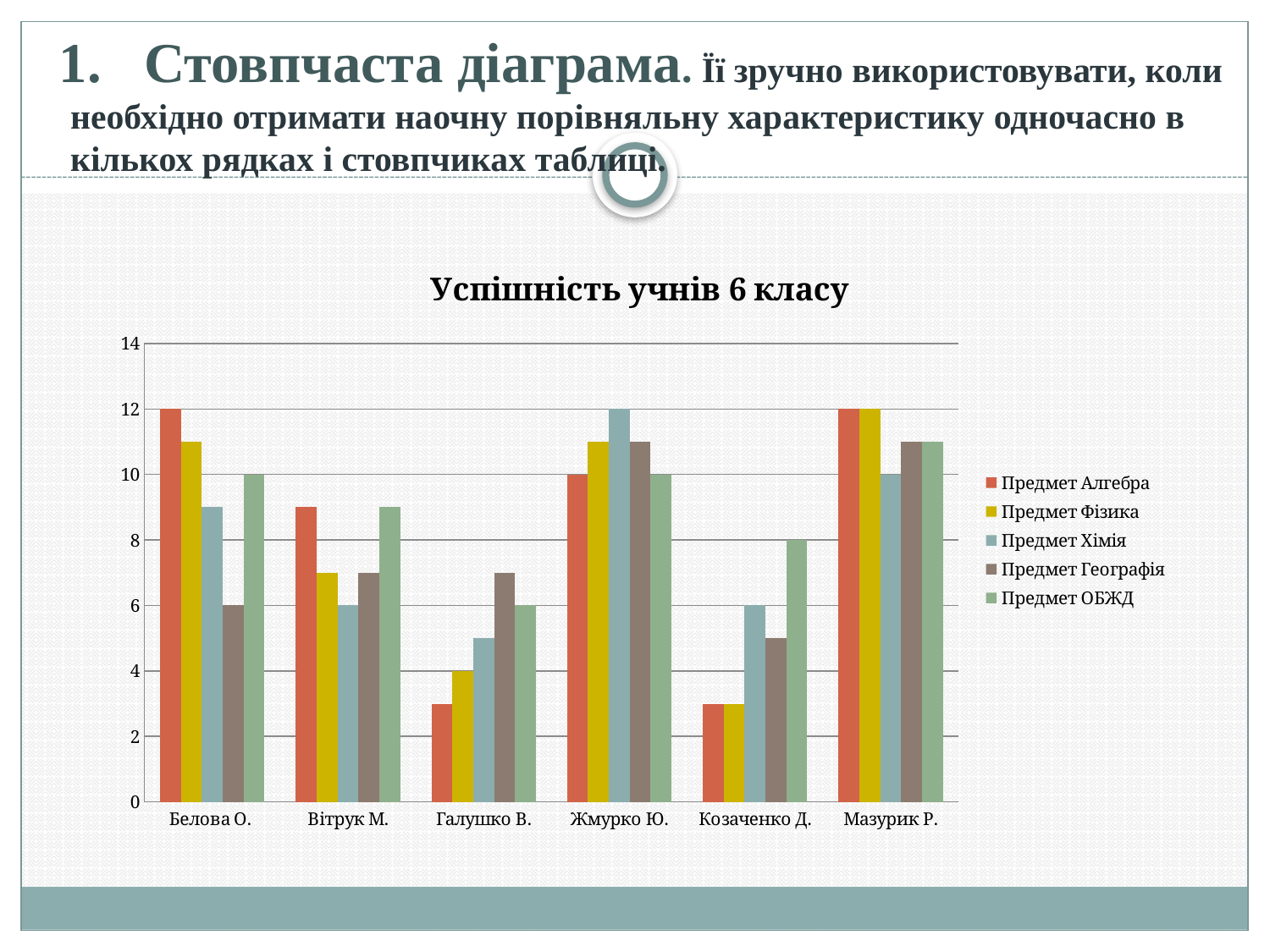
What is the difference between Предмет Алгебра and Предмет Хімія for Мазурик Р.? 2 Is the value for Предмет Алгебра for Вітрук М. greater or less than 8? greater What is the title of the chart? Успішність учнів 6 класу What type of chart is shown on the slide? bar chart Which student has the lowest value for Предмет ОБЖД? Галушко В. Which is larger for Белова О.: Предмет Алгебра or Предмет Географія? Предмет Алгебра Which student has the highest value for Предмет Хімія? Жмурко Ю. What is the value for Предмет Алгебра for Белова О.? 12 How many students (categories) are shown on the x axis? 6 How many series does the legend list? 5 What is the value for Предмет Хімія for Жмурко Ю.? 12 What is the value for Предмет ОБЖД for Козаченко Д.? 8